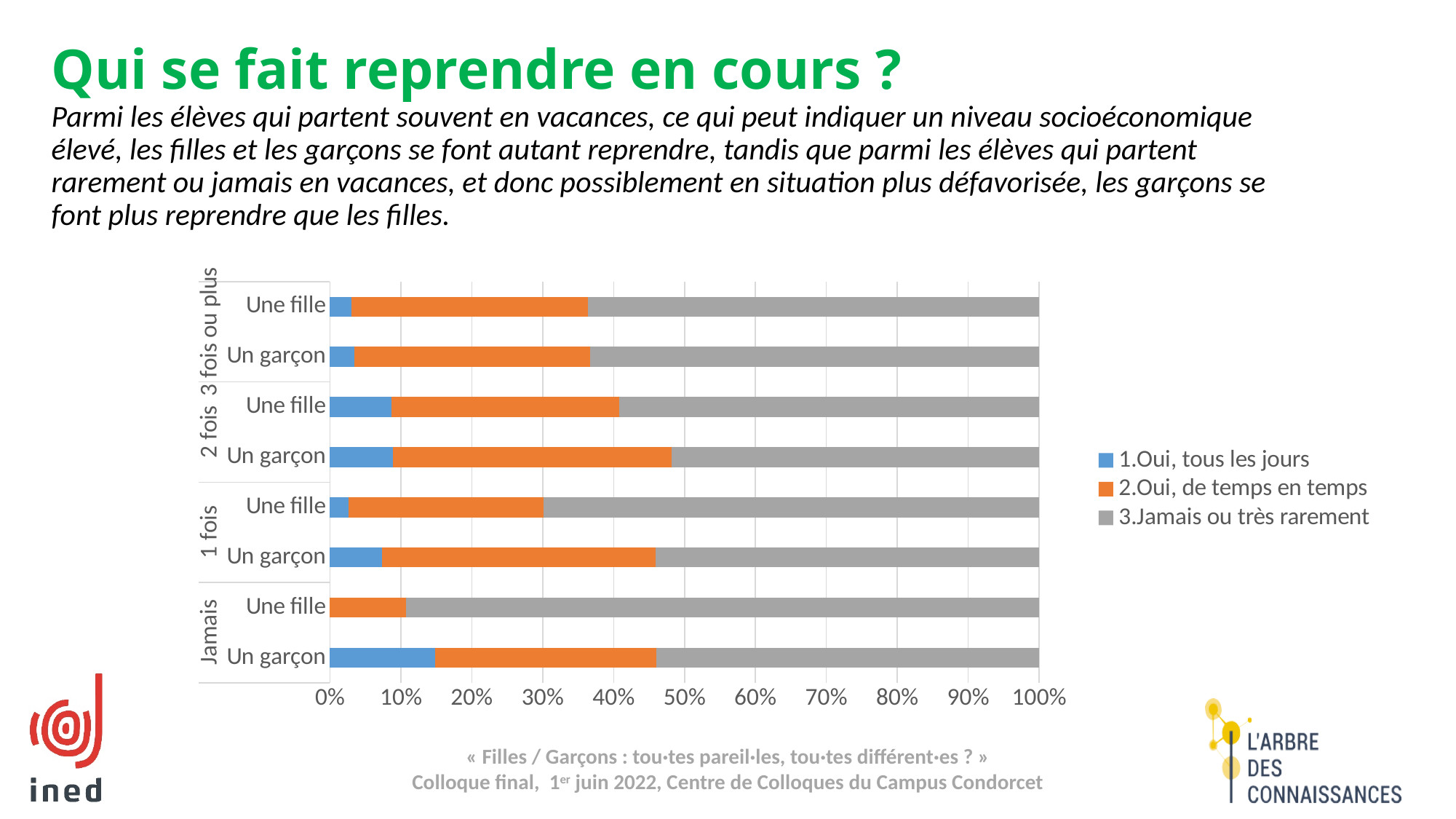
Is the combined share of "Oui, tous les jours" and "Oui, de temps en temps" for "Un garçon" in the "1 fois" group greater or less than 40%? greater What kind of chart is shown on the slide? Stacked bar chart What is the first entry listed in the legend? 1.Oui, tous les jours Is the combined share of "Oui, tous les jours" and "Oui, de temps en temps" for "Une fille" in the "3 fois ou plus" group greater or less than 40%? less Is the combined share of "Oui, tous les jours" and "Oui, de temps en temps" for "Un garçon" in the "2 fois" group greater or less than 50%? less In the "1 fois" group, which has the larger "3.Jamais ou très rarement" share, "Une fille" or "Un garçon"? Une fille Which colour represents the series "3.Jamais ou très rarement"? Grey In the "Jamais" group, which has the larger "1.Oui, tous les jours" share, "Une fille" or "Un garçon"? Un garçon Which bar has the largest "1.Oui, tous les jours" segment? Un garçon, Jamais How many series does the legend list? 3 How many bars are plotted in the chart? 8